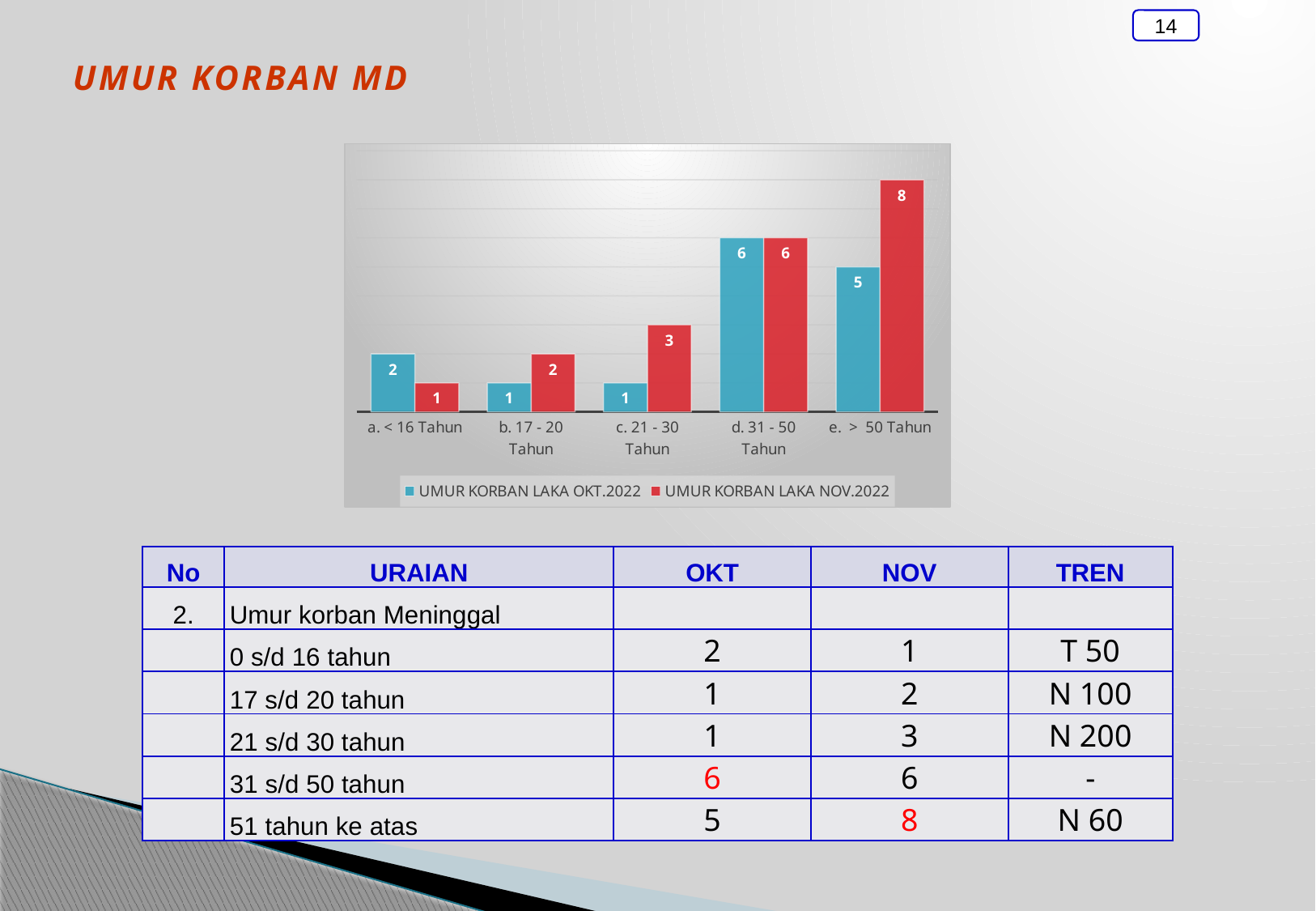
Which category has the highest value for UMUR KORBAN LAKA OKT.2022? d. 31 - 50 Tahun What is the value for UMUR KORBAN LAKA NOV.2022 in the category e. > 50 Tahun? 8 Which category has the highest value for UMUR KORBAN LAKA NOV.2022? e. > 50 Tahun What is the difference between the NOV.2022 and OKT.2022 values for e. > 50 Tahun? 3 What kind of chart is shown on the slide? Bar chart What colour are the bars for UMUR KORBAN LAKA NOV.2022? Red What is the value for UMUR KORBAN LAKA OKT.2022 in the category d. 31 - 50 Tahun? 6 What is the value for UMUR KORBAN LAKA NOV.2022 in the category c. 21 - 30 Tahun? 3 How many series does the chart legend list? 2 How many age categories are shown on the x axis of the chart? 5 Which category has the lowest value for UMUR KORBAN LAKA NOV.2022? a. < 16 Tahun Which is larger for a. < 16 Tahun: the OKT.2022 value or the NOV.2022 value? OKT.2022